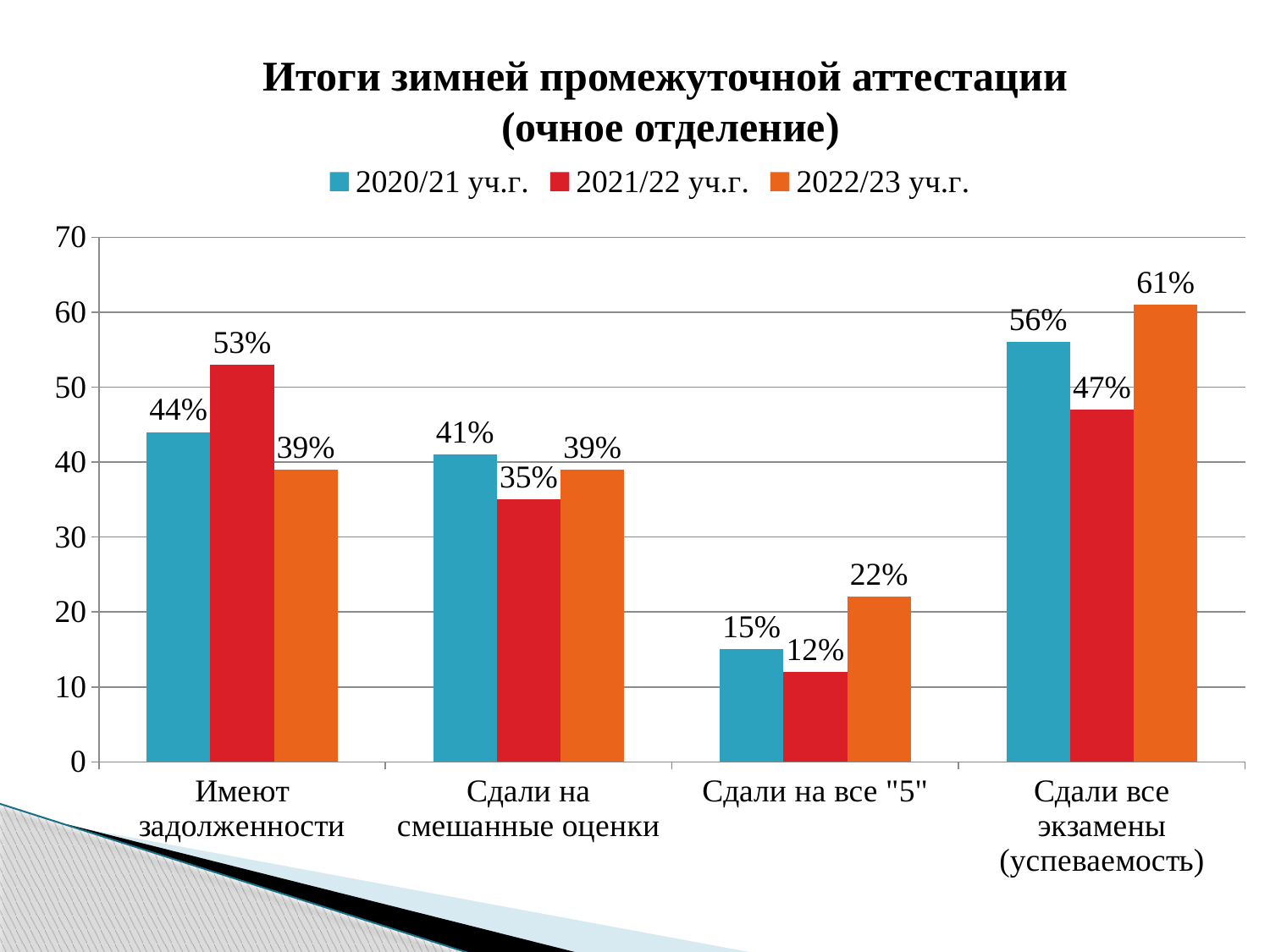
Which category has the lowest value for 2021/22 уч.г.? Сдали на все "5" In the category "Сдали на смешанные оценки", which series has the larger value: 2020/21 уч.г. or 2021/22 уч.г.? 2020/21 уч.г. What is the title of the chart? Итоги зимней промежуточной аттестации (очное отделение) Which category has the highest value for 2022/23 уч.г.? Сдали все экзамены (успеваемость) What is the value for 2021/22 уч.г. in the category "Имеют задолженности"? 53% What is the value for 2022/23 уч.г. in the category "Сдали на все "5""? 22% What is the difference between the 2022/23 уч.г. and 2020/21 уч.г. values in the category "Сдали все экзамены (успеваемость)"? 5% Is the value for 2021/22 уч.г. in the category "Имеют задолженности" greater or less than 50? greater What is the value for 2020/21 уч.г. in the category "Сдали все экзамены (успеваемость)"? 56% How many categories are shown on the x axis? 4 What kind of chart is shown on the slide? bar chart How many series does the legend list? 3